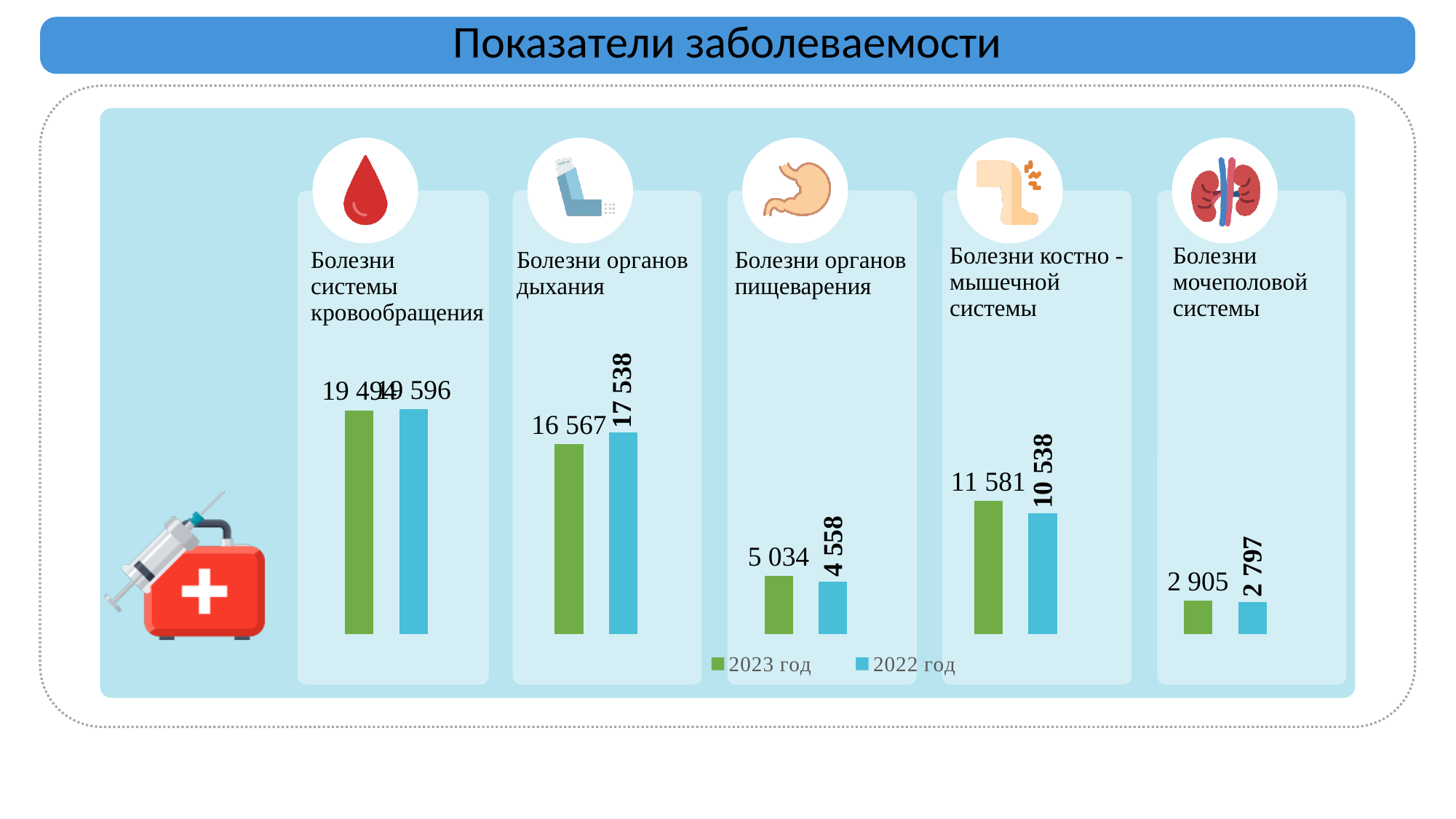
How many series does the legend list? 2 What is the 2022 год value for Болезни органов дыхания? 17 538 What is the 2022 год value for Болезни костно-мышечной системы? 10 538 What is the difference between the 2023 год and 2022 год values for Болезни органов пищеварения? 476 What is the difference between the 2023 год and 2022 год values for Болезни костно-мышечной системы? 1 043 What is the 2023 год value for Болезни мочеполовой системы? 2 905 Which is larger for Болезни органов дыхания: the 2023 год value or the 2022 год value? 2022 год How many disease categories are shown in the chart? 5 Which disease category has the lowest values in the chart? Болезни мочеполовой системы What is the 2023 год value for Болезни органов дыхания? 16 567 Which disease category has the highest values in the chart? Болезни системы кровообращения What is the 2023 год value for Болезни органов пищеварения? 5 034